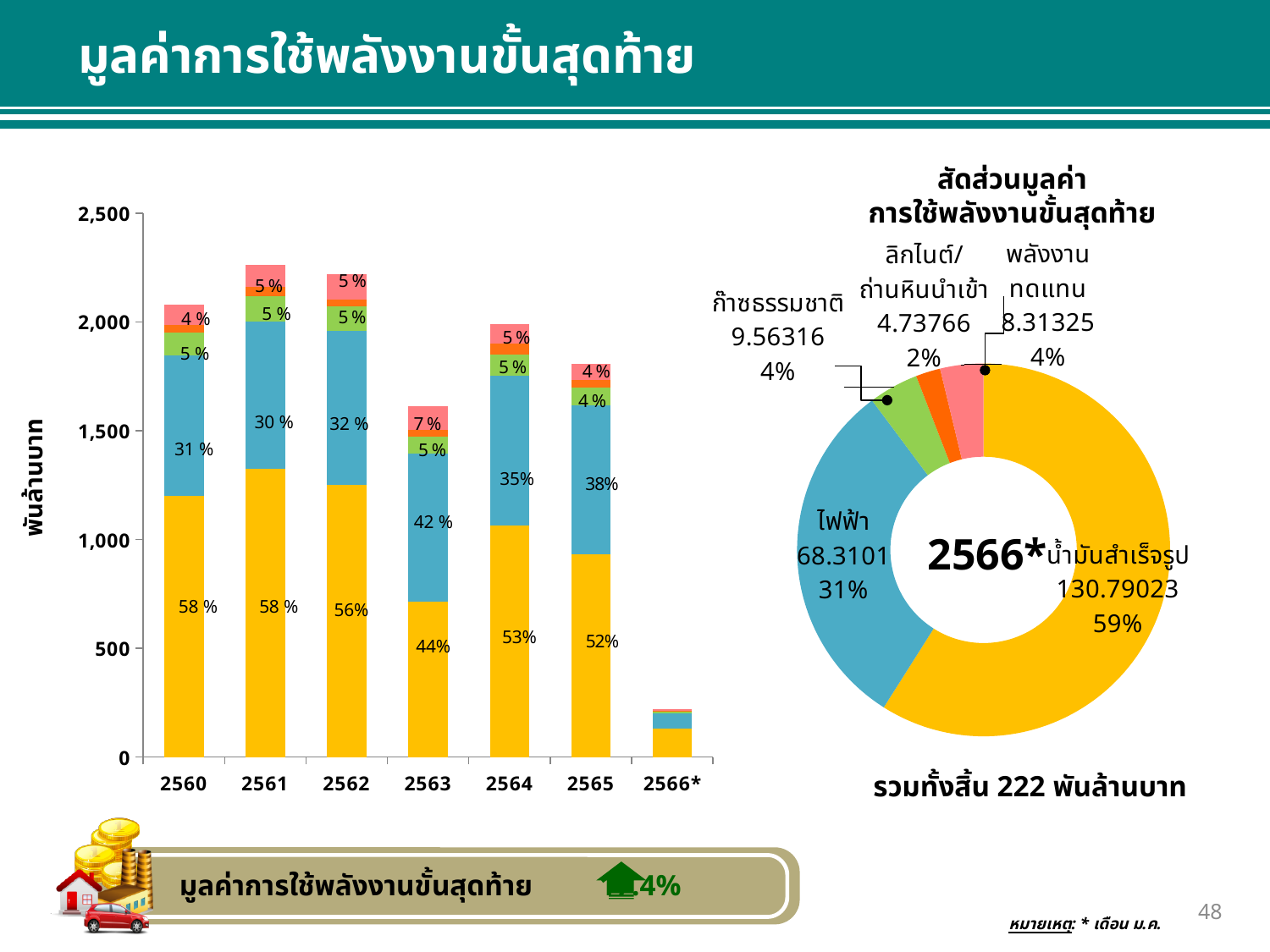
In the bar chart on the left, is the total height of the 2560 bar greater or less than 2,000? greater In the bar chart on the left, what percentage is labelled on the bottom (yellow) segment of the 2563 bar? 44% In the doughnut chart on the right, which category has the smallest share? ลิกไนต์/ถ่านหินนำเข้า How many categories are shown in the doughnut chart on the right? 5 What total is stated below the doughnut chart on the right? 222 พันล้านบาท How many years are shown on the x axis of the bar chart on the left? 7 In the doughnut chart on the right, what is the difference between the values for ไฟฟ้า and ก๊าซธรรมชาติ? 58.74694 In the doughnut chart on the right, what value is shown for น้ำมันสำเร็จรูป? 130.79023 In the doughnut chart on the right, which category has the largest share? น้ำมันสำเร็จรูป What kind of chart is the chart on the left of the slide? Stacked bar chart In the doughnut chart on the right, what share of the total does ไฟฟ้า account for? 31% In the bar chart on the left, which year has the lowest total bar? 2566*